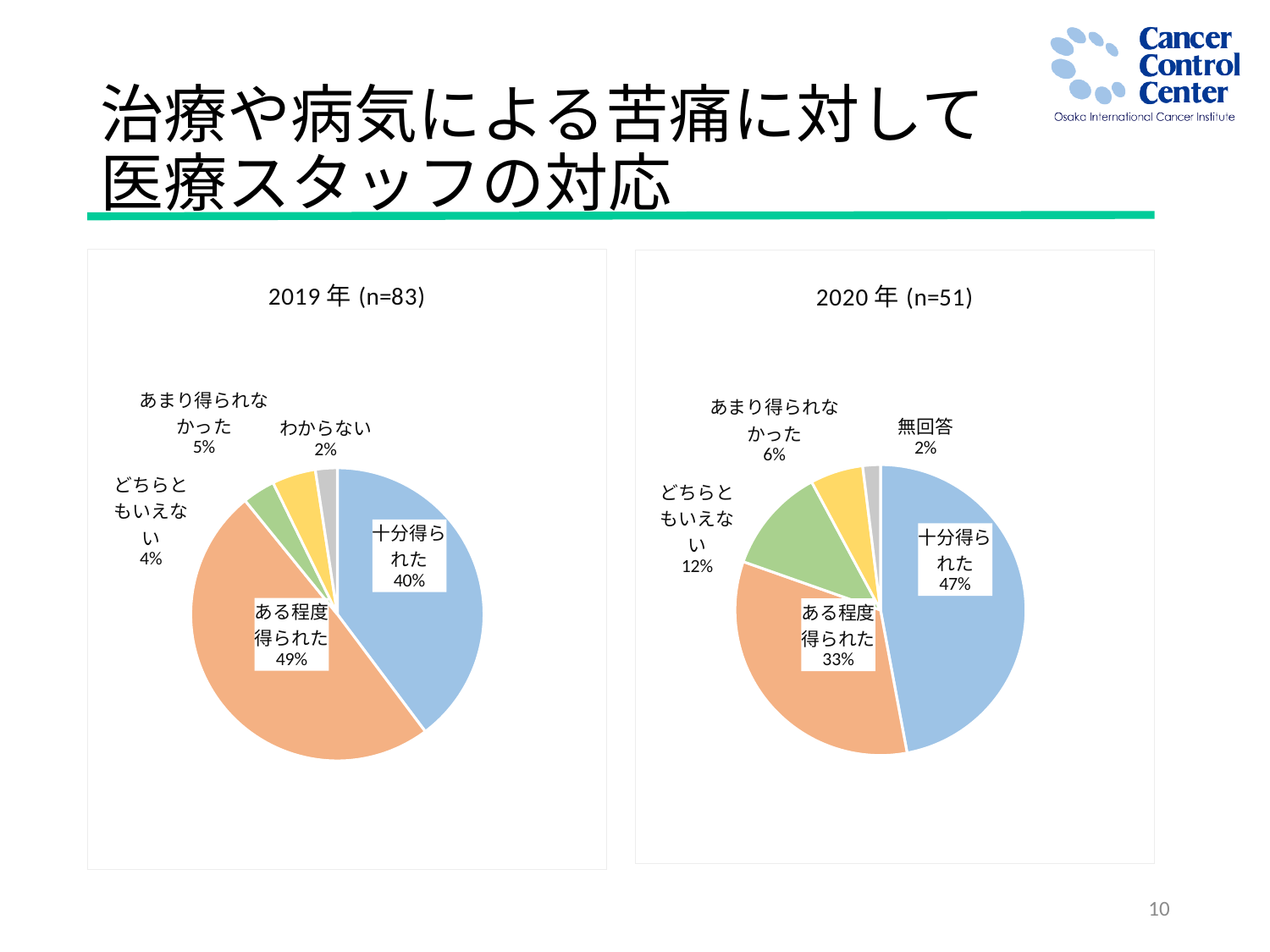
In the 2020年 (n=51) chart, what is the difference between the shares for 十分得られた and ある程度得られた? 14% In the 2019年 (n=83) chart, what share is labelled for ある程度得られた? 49% In the 2019年 (n=83) chart, which is larger, the share for あまり得られなかった or the share for どちらともいえない? あまり得られなかった In the 2020年 (n=51) chart, what share is labelled for どちらともいえない? 12% In the 2020年 (n=51) chart, which category has the smallest slice? 無回答 In the 2019年 (n=83) chart, which category has the smallest slice? わからない How many slices does the 2020年 (n=51) chart have? 5 What kind of chart is the 2019年 (n=83) chart? Pie chart In the 2019年 (n=83) chart, which category has the largest slice? ある程度得られた In the 2020年 (n=51) chart, which category has the largest slice? 十分得られた In the 2020年 (n=51) chart, what share is labelled for 十分得られた? 47%